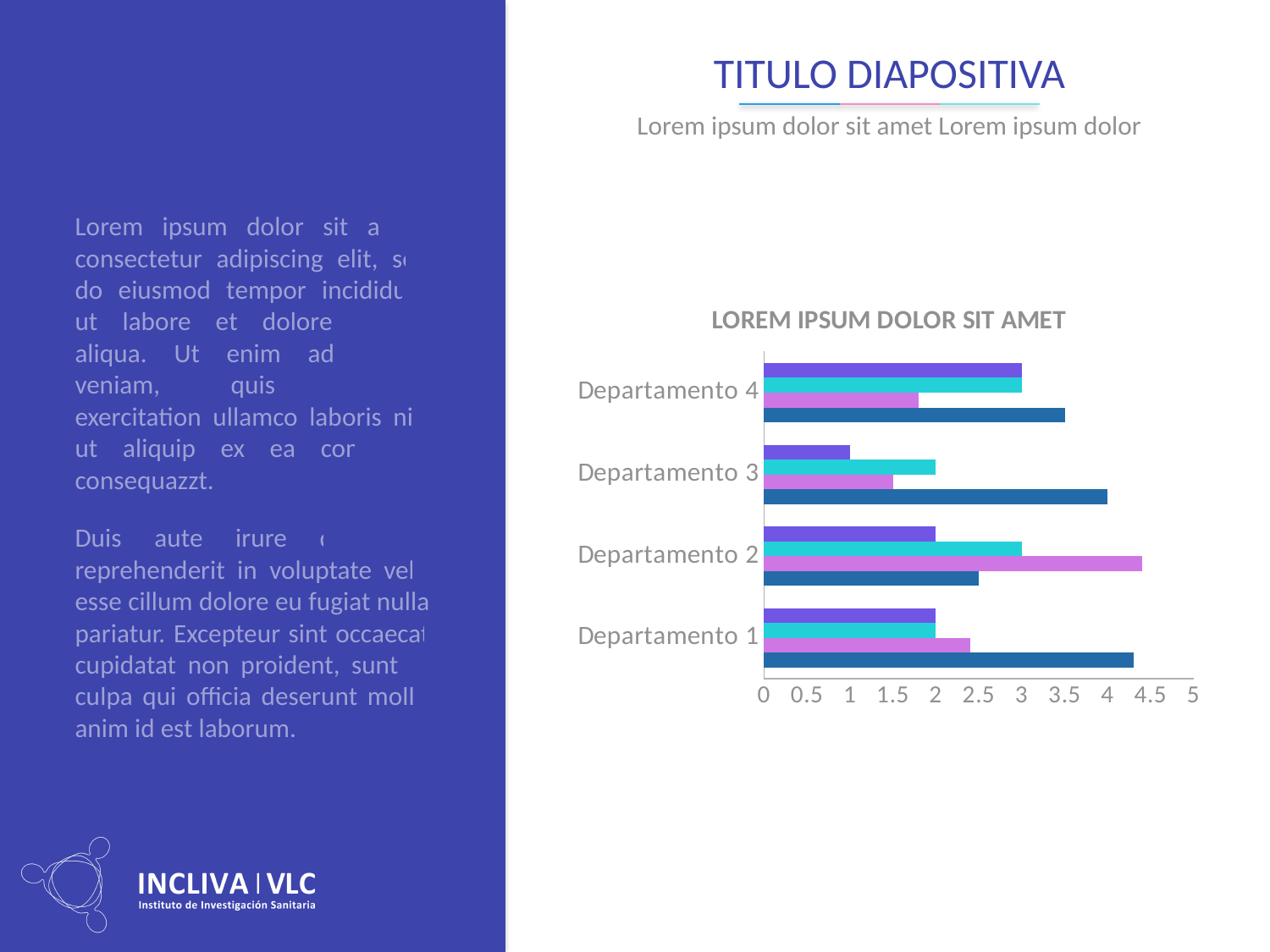
What kind of chart is shown on the slide? bar chart What is the value of the dark blue bar for Departamento 4? 3.5 What is the value of the purple bar for Departamento 3? 1 What is the title of the chart? LOREM IPSUM DOLOR SIT AMET Is the value of the magenta bar for Departamento 4 greater or less than 2? less Which bar is the longest for Departamento 3? the dark blue bar How many bars are plotted for each departamento? 4 Which is larger: the dark blue bar for Departamento 3 or the dark blue bar for Departamento 2? Departamento 3 What is the value of the dark blue bar for Departamento 3? 4 Which bar is the shortest for Departamento 4? the magenta bar How many categories (departamentos) are shown on the chart? 4 Is the value of the magenta bar for Departamento 2 greater or less than 4? greater